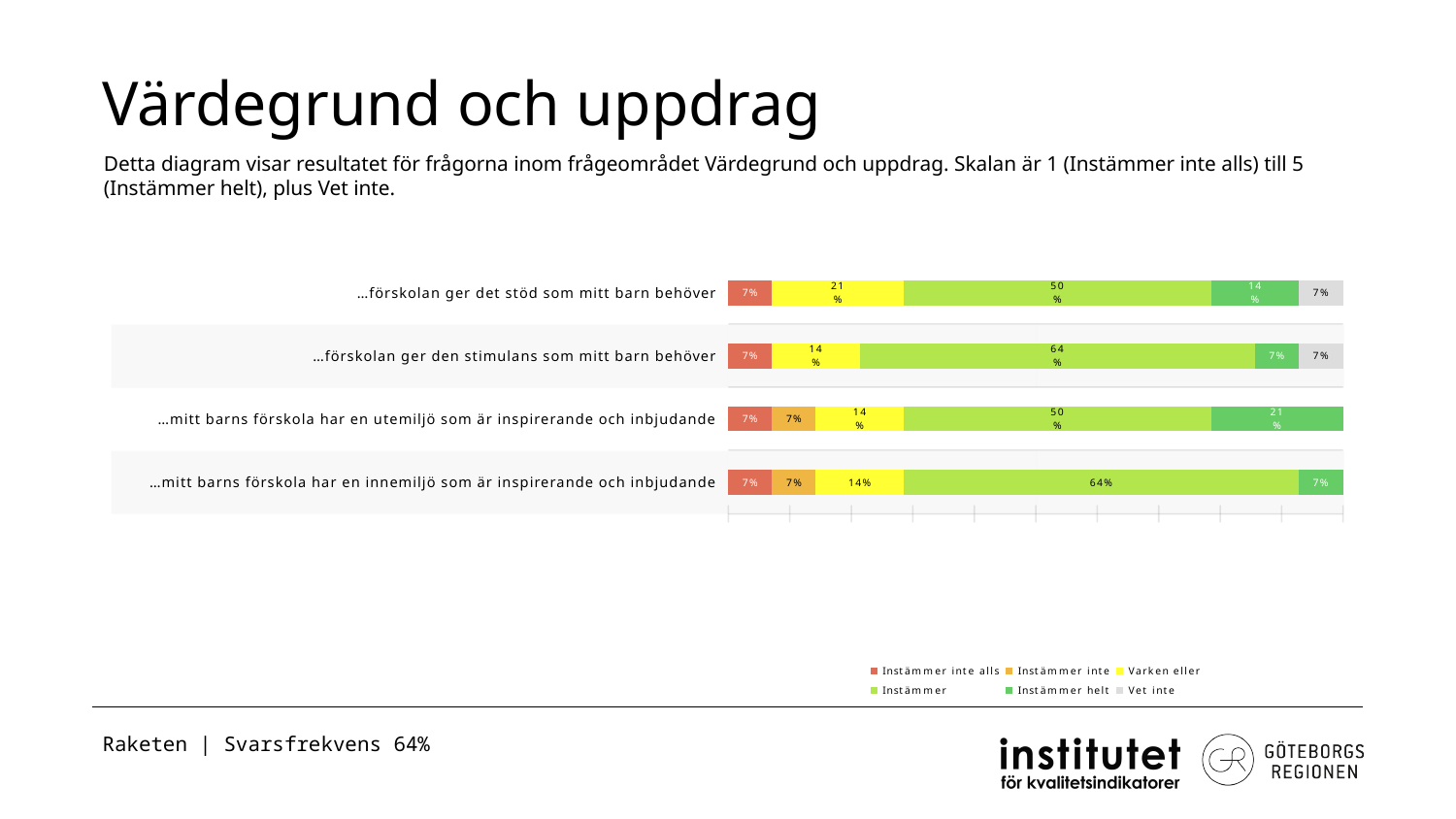
What is the 'Instämmer' value for '…förskolan ger den stimulans som mitt barn behöver'? 64% What is the 'Instämmer inte alls' value for '…mitt barns förskola har en innemiljö som är inspirerande och inbjudande'? 7% How many series does the legend list? 6 What kind of chart is shown on the slide? Stacked bar chart Which is larger: the 'Varken eller' value for '…förskolan ger det stöd som mitt barn behöver' or for '…förskolan ger den stimulans som mitt barn behöver'? …förskolan ger det stöd som mitt barn behöver What is the 'Instämmer helt' value for '…mitt barns förskola har en utemiljö som är inspirerande och inbjudande'? 21% Which statement has the highest 'Instämmer helt' share? …mitt barns förskola har en utemiljö som är inspirerande och inbjudande What is the difference between the 'Instämmer' values for '…förskolan ger den stimulans som mitt barn behöver' and '…förskolan ger det stöd som mitt barn behöver'? 14 percentage points What is the 'Vet inte' value for '…förskolan ger den stimulans som mitt barn behöver'? 7% How many statements (categories) are plotted in the chart? 4 Which legend entry is shown in red? Instämmer inte alls What is the 'Varken eller' value for '…förskolan ger det stöd som mitt barn behöver'? 21%